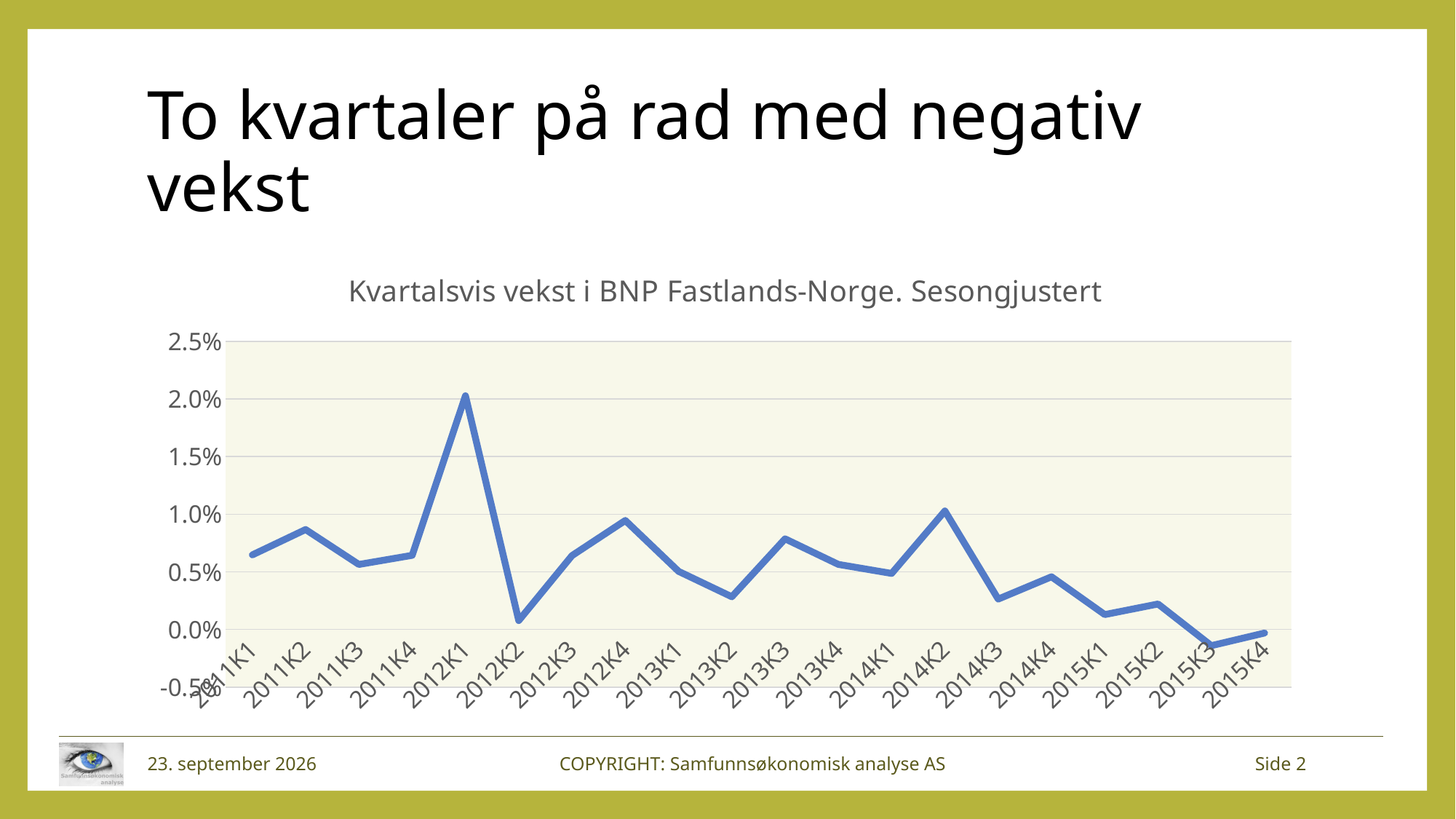
How many quarters are plotted along the x axis? 20 Is the value for 2012K2 greater or less than 0.5%? less Which is larger, the value for 2012K1 or the value for 2014K2? 2012K1 Is the value for 2014K2 greater or less than 0.5%? greater Which is larger, the value for 2011K2 or the value for 2013K2? 2011K2 What kind of chart is shown on the slide? Line chart Which quarter has the highest growth value? 2012K1 Which quarter has the lowest growth value? 2015K3 What is the title of the chart? Kvartalsvis vekst i BNP Fastlands-Norge. Sesongjustert Does the line rise or fall from 2014K2 to 2015K3? Falls Is the value for 2015K3 greater or less than 0.0%? less